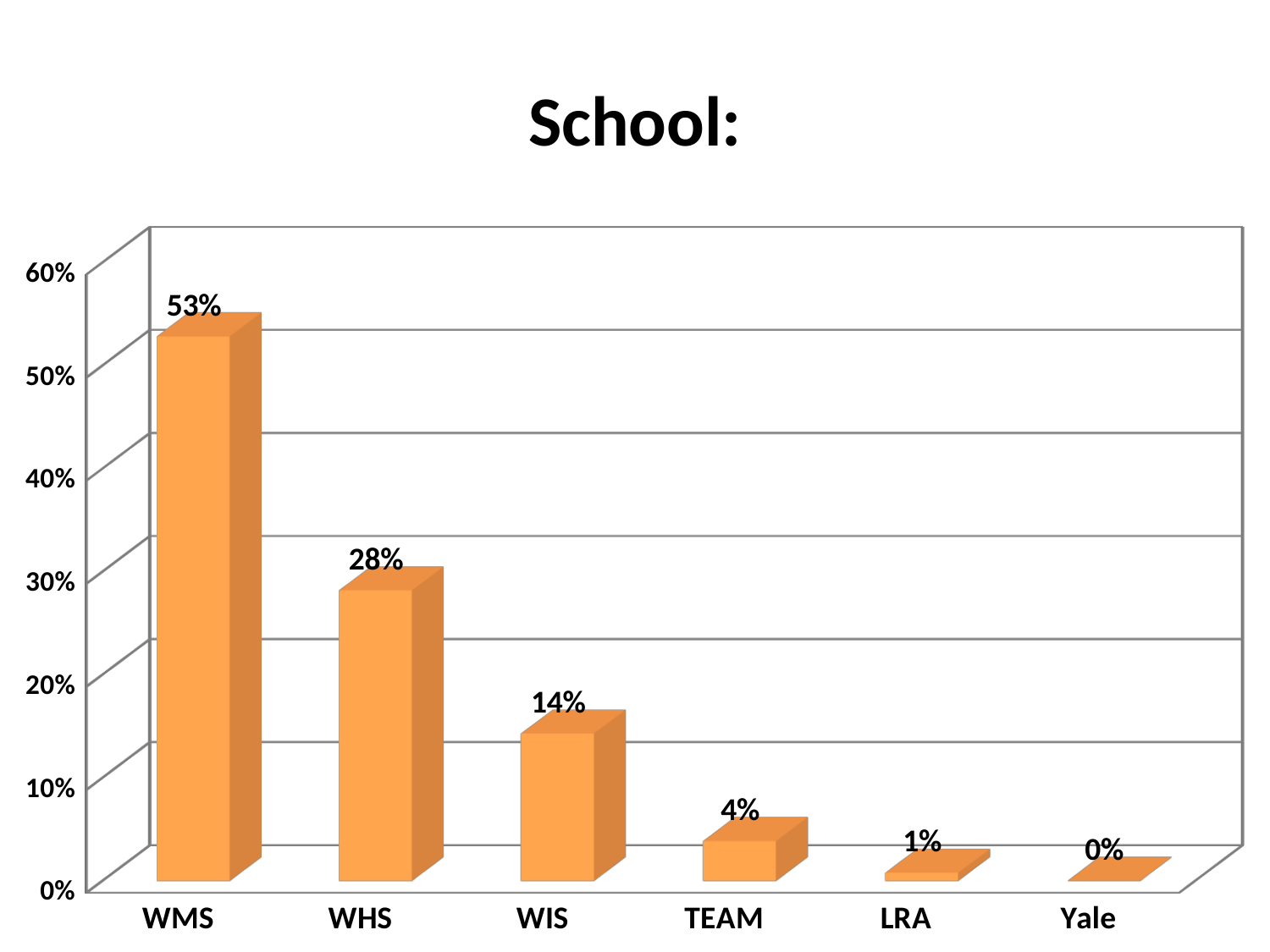
What is the difference between the values for WMS and WHS? 25% What is the value for TEAM? 4% What is the value for WMS? 53% Which school has the highest value? WMS What is the value for WHS? 28% Which is larger, the value for WIS or the value for TEAM? WIS What is the value for LRA? 1% What is the title of the chart? School: What kind of chart is shown on the slide? Bar chart Which school has the lowest value? Yale How many schools are shown on the chart? 6 What is the value for WIS? 14%